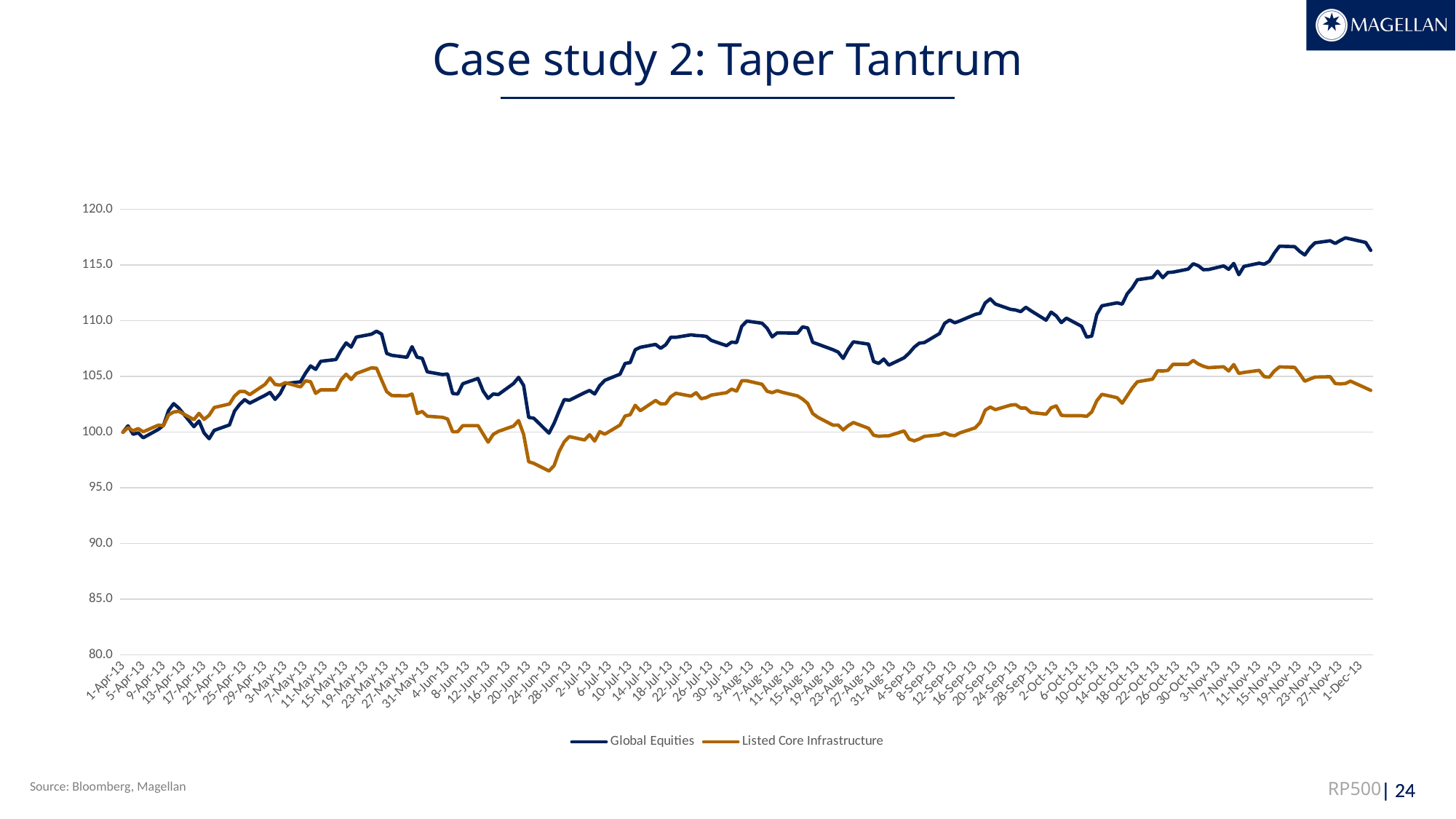
What are the two series named in the legend? Global Equities and Listed Core Infrastructure Is the value for Listed Core Infrastructure on 24-Jun-13 greater or less than 100.0? less On 1-Dec-13, which series has the higher value, Global Equities or Listed Core Infrastructure? Global Equities What kind of chart is shown on the slide? Line chart Overall, does the Global Equities line rise or fall from 1-Apr-13 to 1-Dec-13? Rise Is the value for Global Equities on 1-Dec-13 greater or less than 115.0? greater Is the value for Listed Core Infrastructure on 1-Dec-13 greater or less than 105.0? less On 24-Jun-13, which series has the higher value, Global Equities or Listed Core Infrastructure? Global Equities Which series reaches the highest value anywhere on the chart? Global Equities What is the title of the slide containing the chart? Case study 2: Taper Tantrum How many series does the legend list? 2